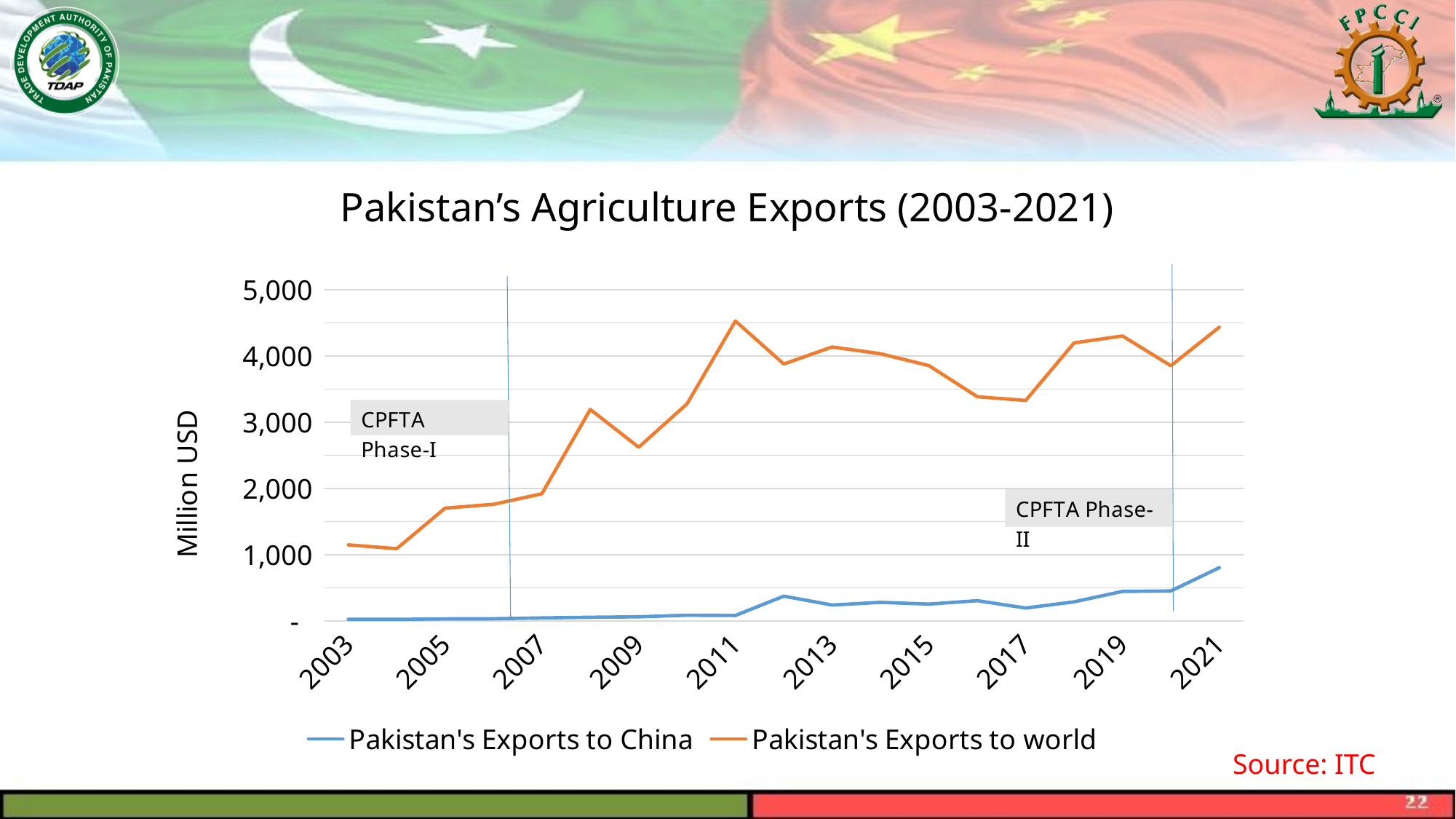
Is the value for Pakistan's Exports to China in 2021 greater or less than 1,000? less What kind of chart is shown on the slide? line chart Is the value for Pakistan's Exports to world in 2011 greater or less than 4,000? greater How many years are plotted along the x axis, from 2003 to 2021? 19 What unit is shown on the y axis label? Million USD Is the value for Pakistan's Exports to world in 2017 greater or less than 4,000? less Overall, do Pakistan's Exports to China rise or fall from 2003 to 2021? rise How many series does the legend list? 2 What is the title of the chart? Pakistan's Agriculture Exports (2003-2021) In 2021, which series has the larger value: Pakistan's Exports to China or Pakistan's Exports to world? Pakistan's Exports to world